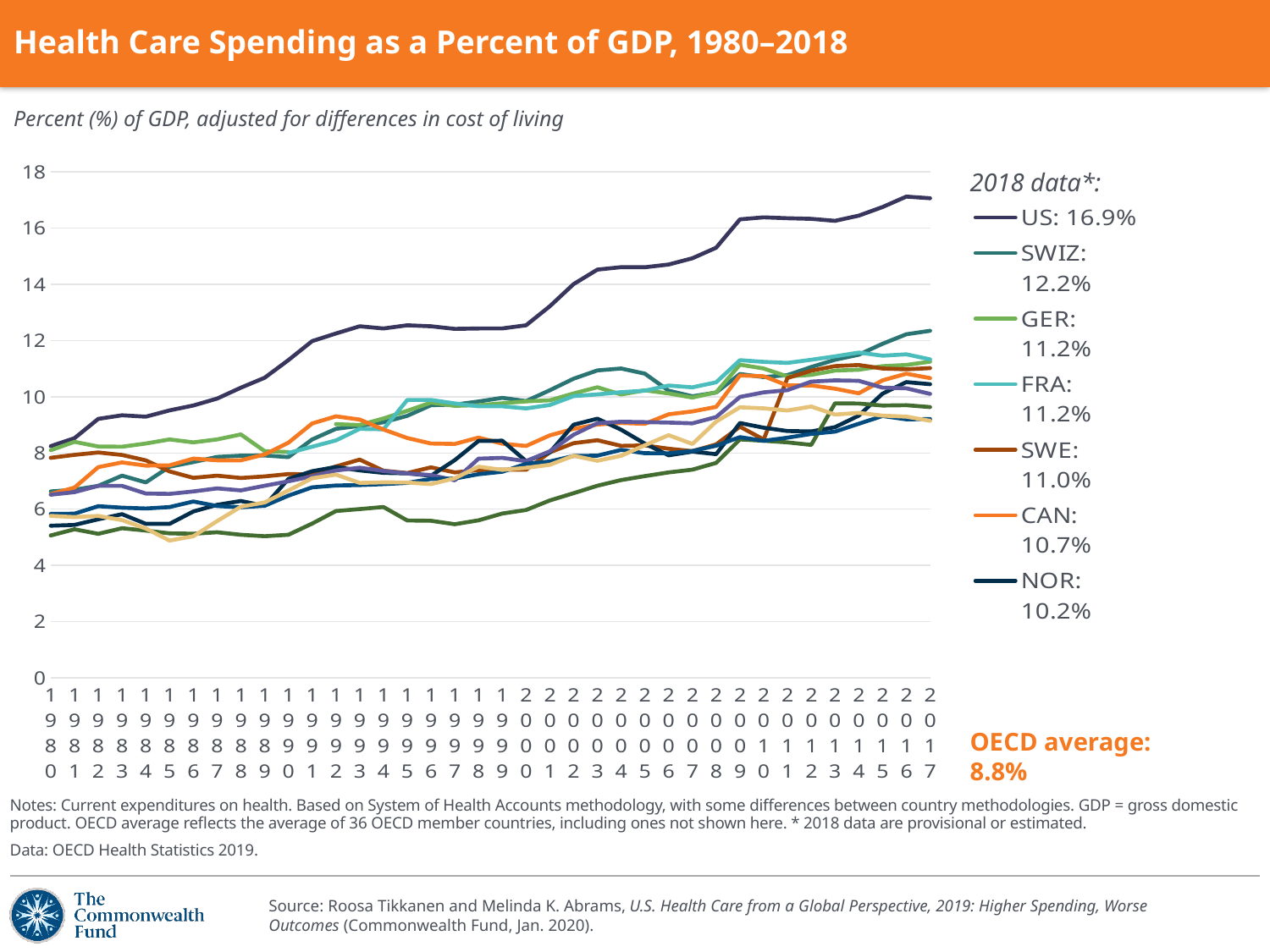
Is the US value in 2000 greater or less than 12? greater What is the OECD average health care spending as a percent of GDP shown on the slide? 8.8% According to the legend, what was US health care spending as a percent of GDP in 2018? 16.9% How many countries does the legend list? 7 Which country has the lowest 2018 value among those listed in the legend? NOR Which country has the highest 2018 value in the legend? US According to the legend, what was Switzerland's (SWIZ) health care spending as a percent of GDP in 2018? 12.2% What kind of chart is shown on the slide? line chart Which has the larger 2018 value, SWIZ or CAN? SWIZ What is the difference between the 2018 values for the US and Switzerland (SWIZ)? 4.7 percentage points Does the US line generally rise or fall from 1980 to 2018? rise What is the title of the chart? Health Care Spending as a Percent of GDP, 1980–2018